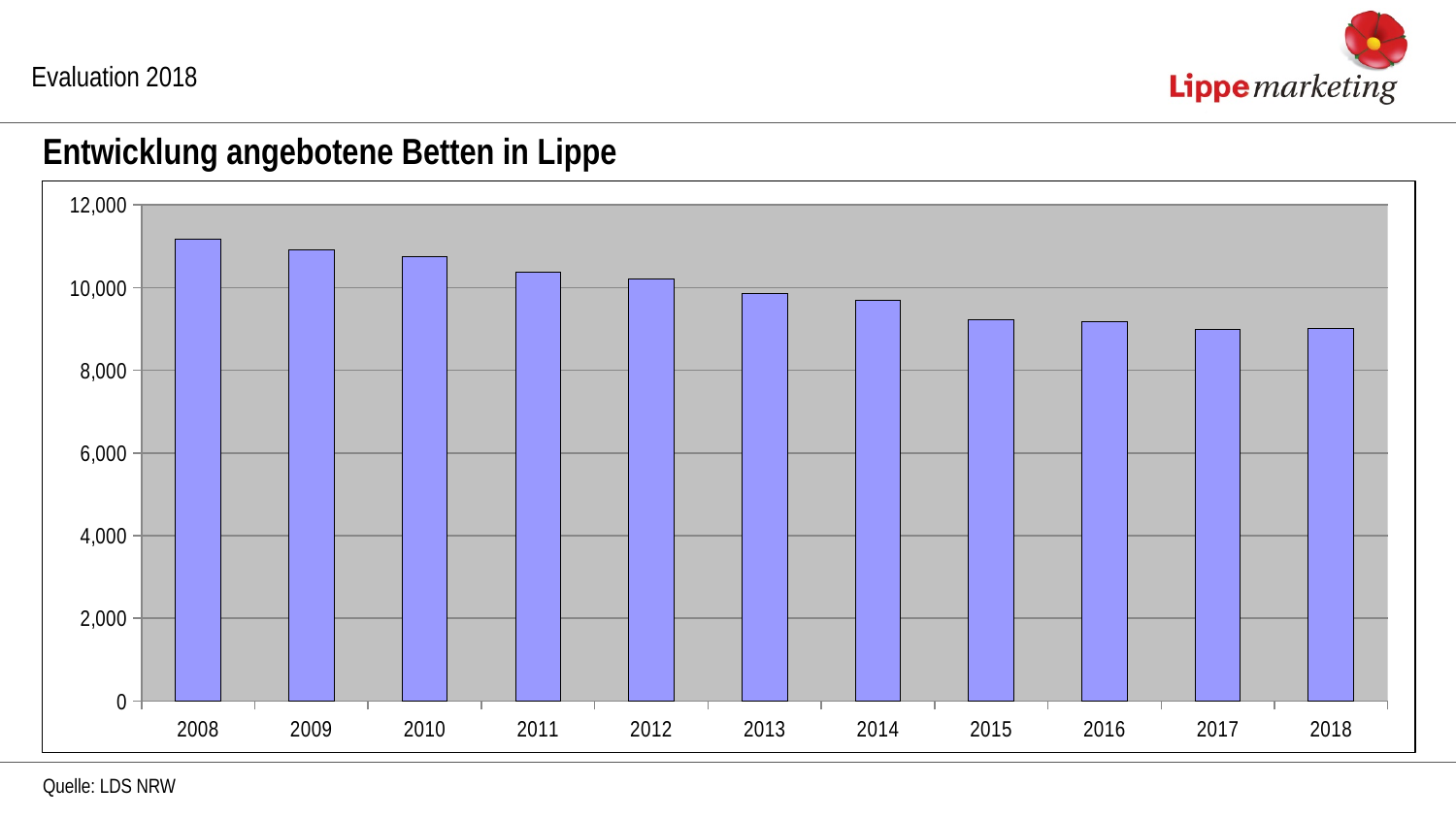
Which year has the highest number of offered beds? 2008 What is the title of the chart? Entwicklung angebotene Betten in Lippe Which is larger, the value for 2010 or the value for 2014? 2010 What source is cited below the chart? LDS NRW Is the value for 2008 greater or less than 10,000? greater Do the values generally rise or fall from 2008 to 2018? fall What kind of chart is shown on the slide? bar chart How many years are shown on the x axis of the chart? 11 Is the value for 2013 greater or less than 10,000? less Which is larger, the value for 2008 or the value for 2018? 2008 Is the value for 2015 greater or less than 8,000? greater